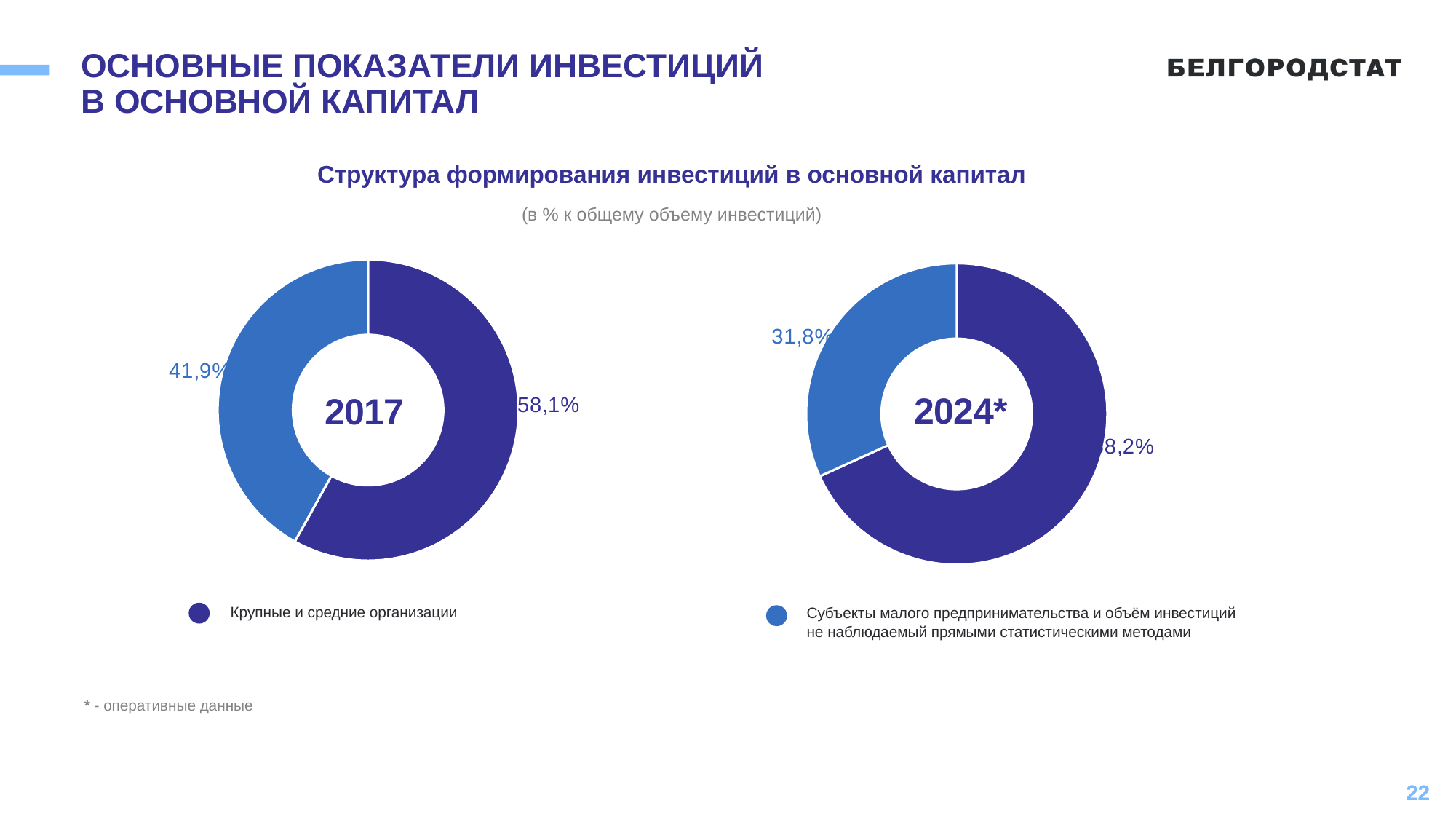
Is the share of small business entities larger in the 2017 chart or in the 2024* chart? 2017 In the 2017 chart, which category has the larger share? Крупные и средние организации In the 2017 chart, what is the difference between the share of large and medium organizations and the share of small business entities? 16,2% In the 2017 chart, what share of investment comes from small business entities and investment not observed by direct statistical methods? 41,9% In the 2024* chart, which category has the smaller share? Субъекты малого предпринимательства и объём инвестиций не наблюдаемый прямыми статистическими методами What type of chart is used to show the structure of investment in fixed capital? Donut (pie) chart In the 2017 chart, what share of investment comes from large and medium organizations (Крупные и средние организации)? 58,1% What does the asterisk next to 2024 indicate, according to the footnote? оперативные данные How many categories does each donut chart show? 2 In the 2024* chart, is the share of large and medium organizations greater or less than 50%? greater What colour represents large and medium organizations (Крупные и средние организации) in the charts? Dark blue In the 2024* chart, what share of investment comes from small business entities and investment not observed by direct statistical methods? 31,8%